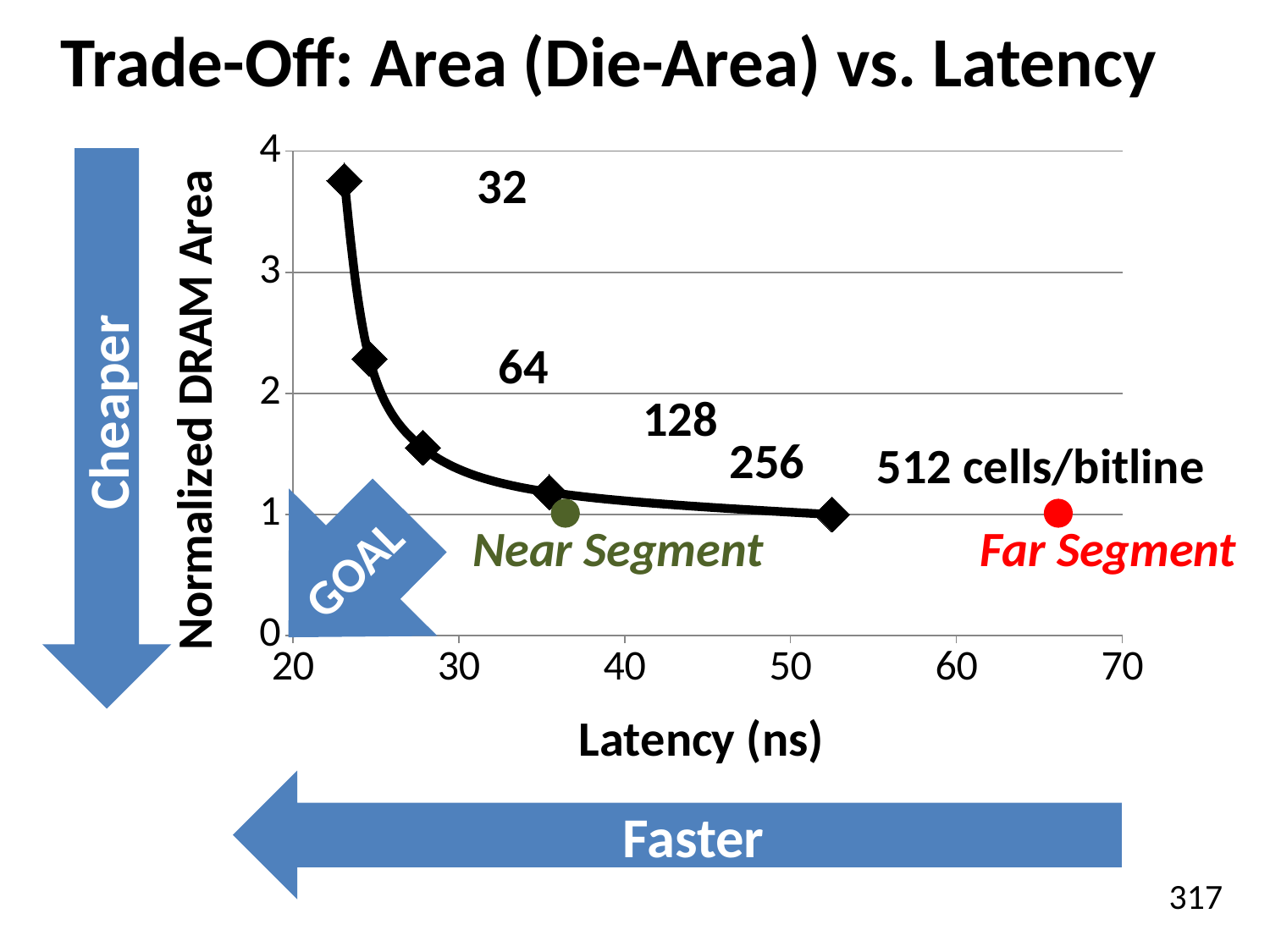
Is the latency for 512 cells/bitline greater or less than 50 ns? greater How many black diamond data points are plotted on the curve? 5 Which cells/bitline configuration has the highest normalized DRAM area? 32 Which has a larger normalized DRAM area, 64 cells/bitline or 128 cells/bitline? 64 cells/bitline Which has a higher latency, the Near Segment or the Far Segment? Far Segment Is the latency for 32 cells/bitline greater or less than 30 ns? less What kind of chart is shown on the slide? line chart Is the latency of the Far Segment point greater or less than 60 ns? greater As latency increases along the x axis, does the normalized DRAM area rise or fall? fall Which cells/bitline configuration has the lowest normalized DRAM area? 512